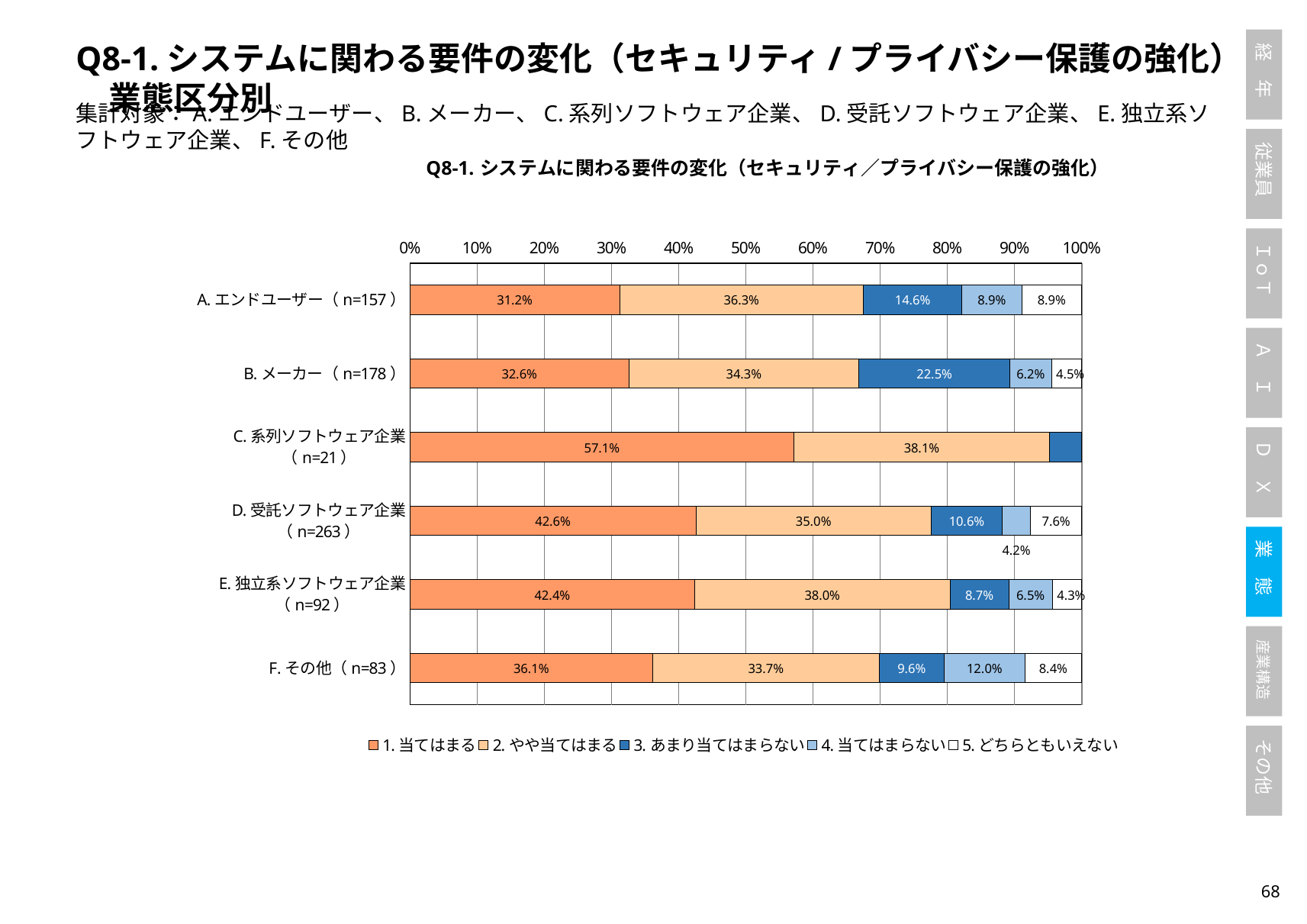
Is the 1. 当てはまる share for C. 系列ソフトウェア企業 greater or less than 50%? greater What is the combined share of 1. 当てはまる and 2. やや当てはまる for E. 独立系ソフトウェア企業? 80.4% What percentage of A. エンドユーザー respondents answered 1. 当てはまる? 31.2% For A. エンドユーザー, how much larger is the 2. やや当てはまる share than the 1. 当てはまる share, in percentage points? 5.1 How many categories (業態) are shown on the chart? 6 What percentage of F. その他 respondents answered 4. 当てはまらない? 12.0% What kind of chart is shown on the slide? Stacked bar chart What is the value of 3. あまり当てはまらない for B. メーカー? 22.5% How many series does the legend list? 5 Which category has the lowest share of 1. 当てはまる? A. エンドユーザー Which is larger: the 3. あまり当てはまらない share for B. メーカー or for D. 受託ソフトウェア企業? B. メーカー Which category has the highest share of 1. 当てはまる? C. 系列ソフトウェア企業